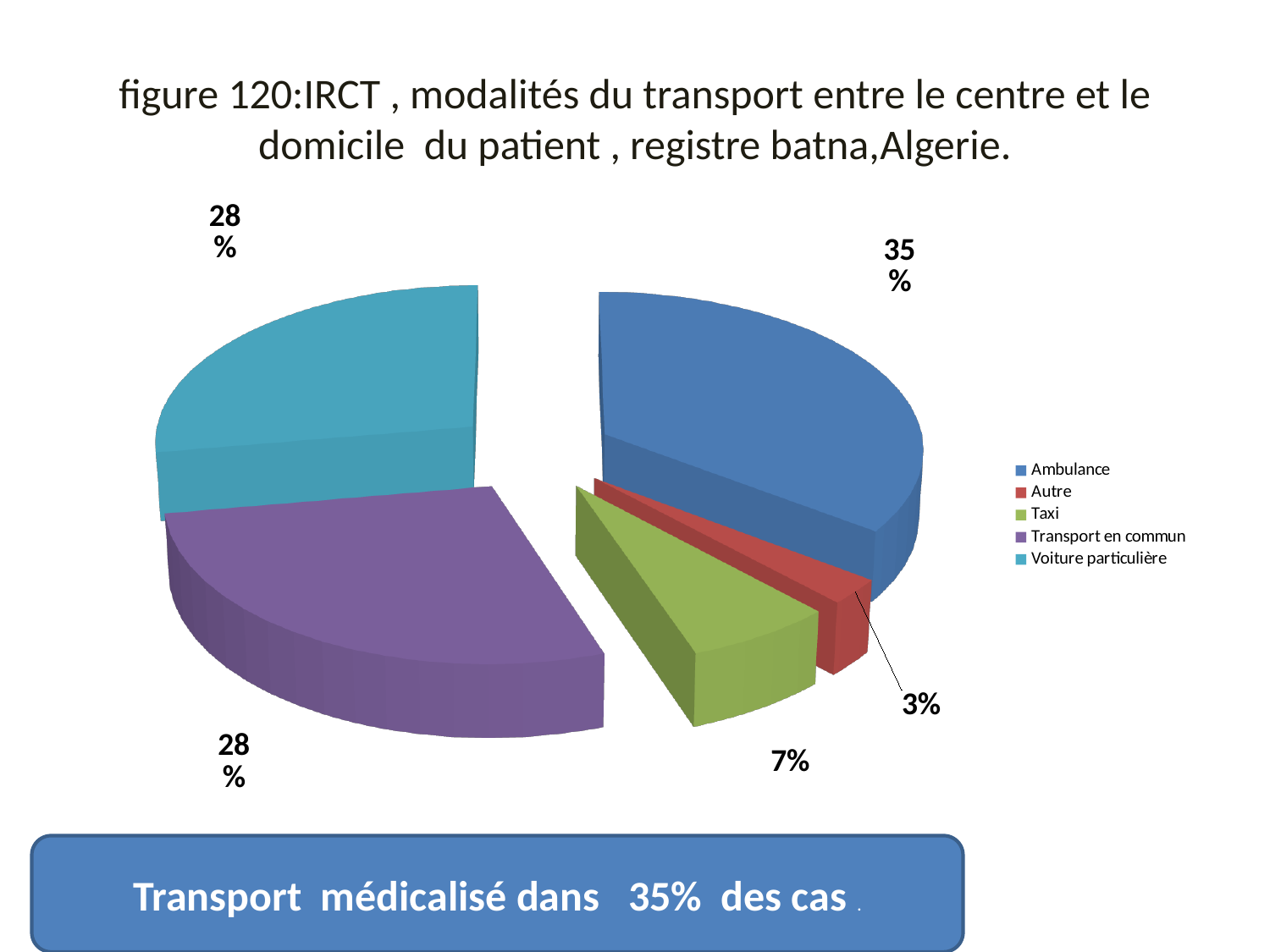
How many categories does the pie chart have? 5 Which colour represents Transport en commun in the legend? purple What percentage of cases used a Taxi? 7% What percentage of cases fall under Autre? 3% Which transport mode has the smallest share of the pie? Autre Which transport mode has the largest share of the pie? Ambulance What is the difference in percentage points between Voiture particulière and Autre? 25 What percentage of cases used Transport en commun? 28% What kind of chart is shown on the slide? pie chart What percentage of cases used an Ambulance for transport? 35% Which is larger, the share for Taxi or the share for Autre? Taxi What is the difference in percentage points between Ambulance and Taxi? 28